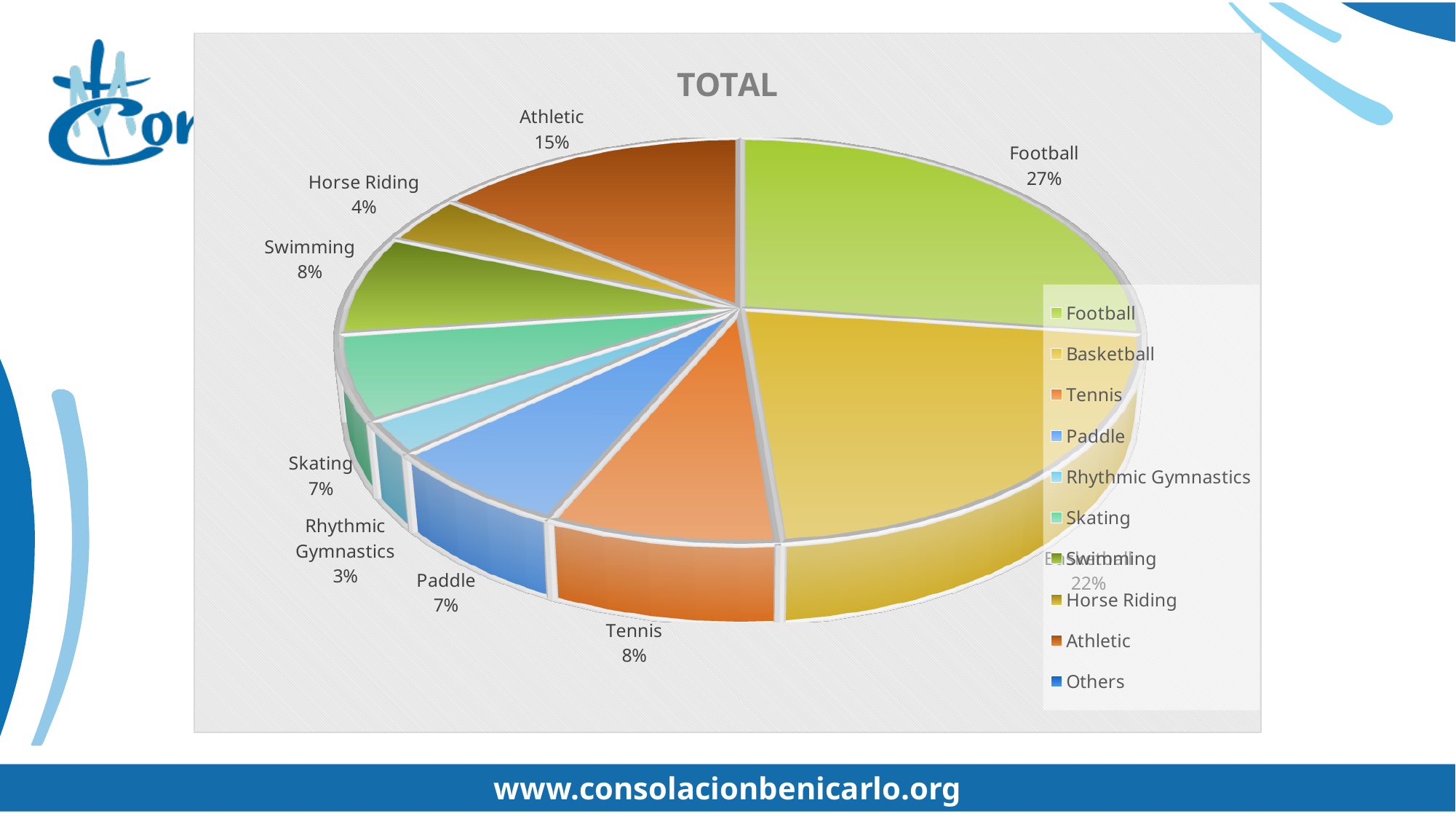
How many percentage points larger is Football than Athletic? 12% Which has the larger share, Tennis or Paddle? Tennis What is the value for Horse Riding? 4% What percentage of the pie does Football represent? 27% What percentage is shown for Swimming? 8% What is the share for Athletic? 15% What is the difference between the Swimming and Horse Riding shares? 4% What percentage is shown for Rhythmic Gymnastics? 3% What kind of chart is shown on the slide? pie chart How many categories does the legend list? 10 What is the title of the chart? TOTAL Which category has the largest slice of the pie? Football